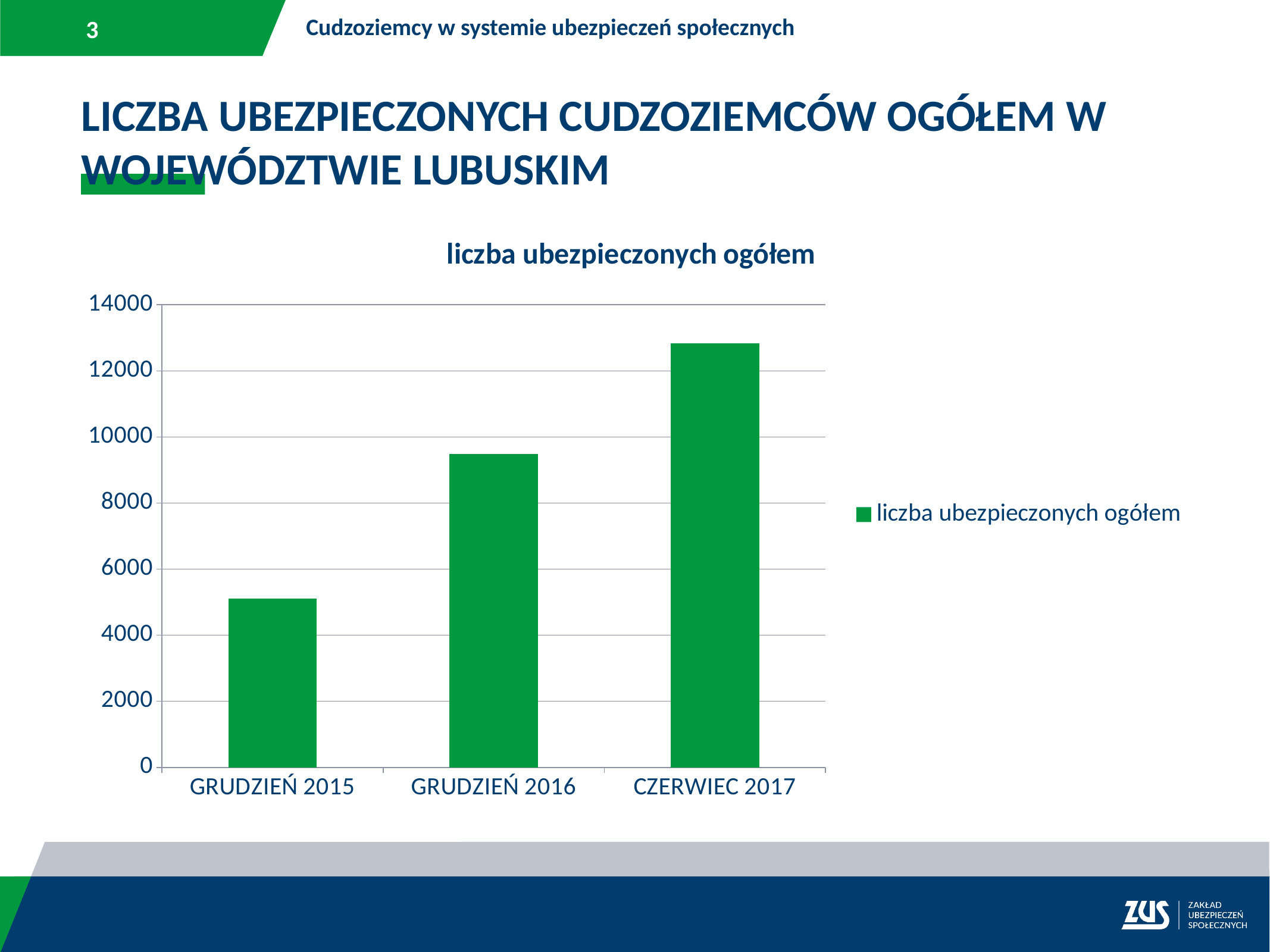
Which category has the lowest value in the chart? GRUDZIEŃ 2015 How many series does the chart legend list? 1 How many categories are shown on the x axis of the chart? 3 Is the value for GRUDZIEŃ 2016 greater or less than 8000? greater Do the values rise or fall from GRUDZIEŃ 2015 to CZERWIEC 2017? rise Which category has the highest value in the chart? CZERWIEC 2017 Is the value for GRUDZIEŃ 2015 greater or less than 6000? less What kind of chart is shown on the slide? bar chart Which is larger, the value for GRUDZIEŃ 2016 or the value for GRUDZIEŃ 2015? GRUDZIEŃ 2016 What colour are the bars in the chart? green Is the value for CZERWIEC 2017 greater or less than 12000? greater What is the title of the chart? liczba ubezpieczonych ogółem